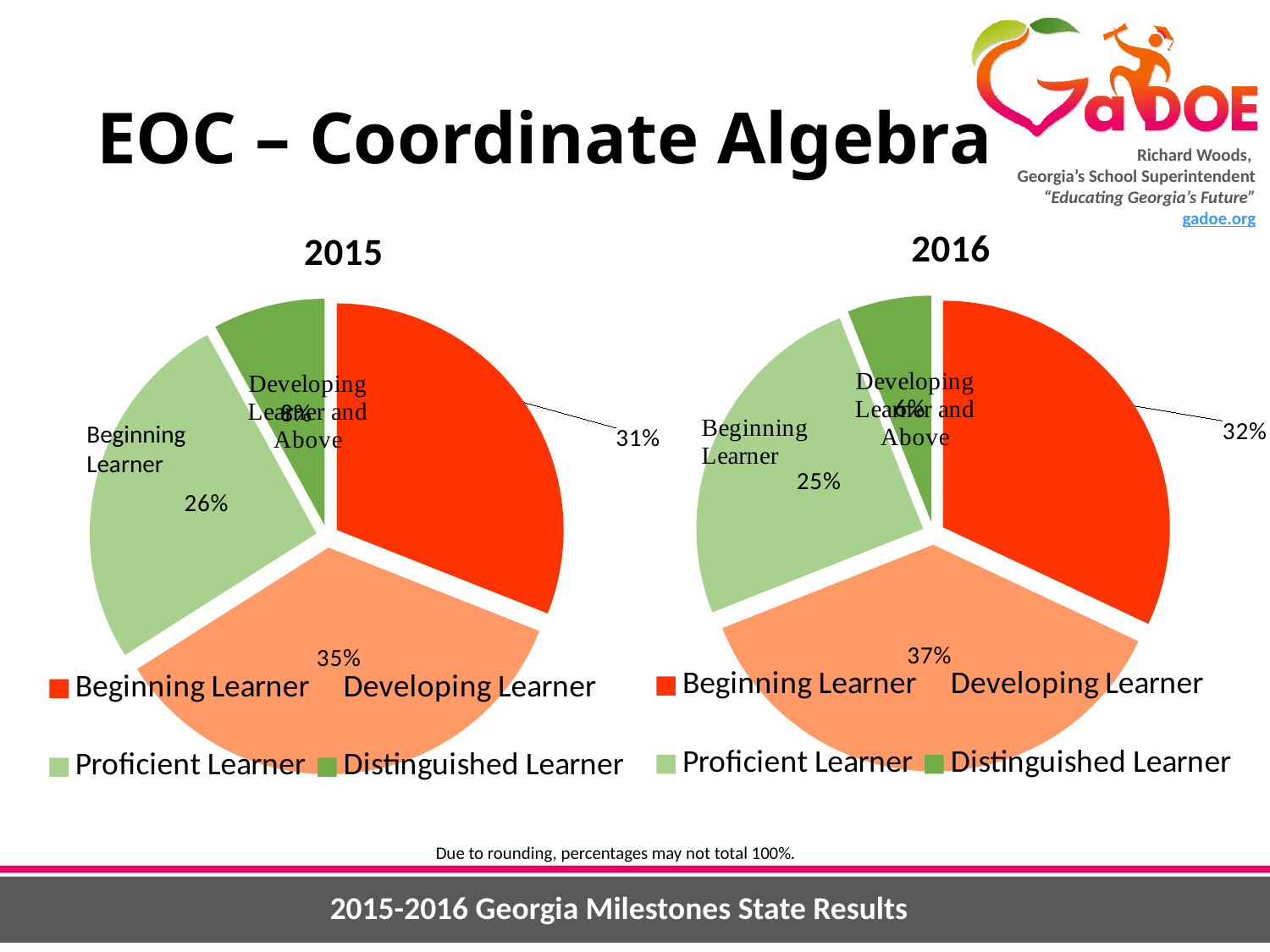
In the 2015 chart, what percentage is shown for Developing Learner? 35% In the 2016 chart, what percentage is shown for Beginning Learner? 32% In the 2016 chart, what percentage is shown for Proficient Learner? 25% What type of chart is used for the 2015 results? Pie chart What is the difference between the Developing Learner percentages in the 2016 chart and the 2015 chart? 2% In the 2015 chart, what is the combined share of Beginning Learner and Developing Learner? 66% Which is larger: Proficient Learner in the 2015 chart or Proficient Learner in the 2016 chart? 2015 (26%) How many entries does the legend of the 2016 chart list? 4 In the 2016 chart, which category has the largest slice? Developing Learner In the 2015 chart, what percentage is shown for Beginning Learner? 31% What colour represents Beginning Learner in the legends? Red In the 2015 chart, which category has the smallest slice? Distinguished Learner